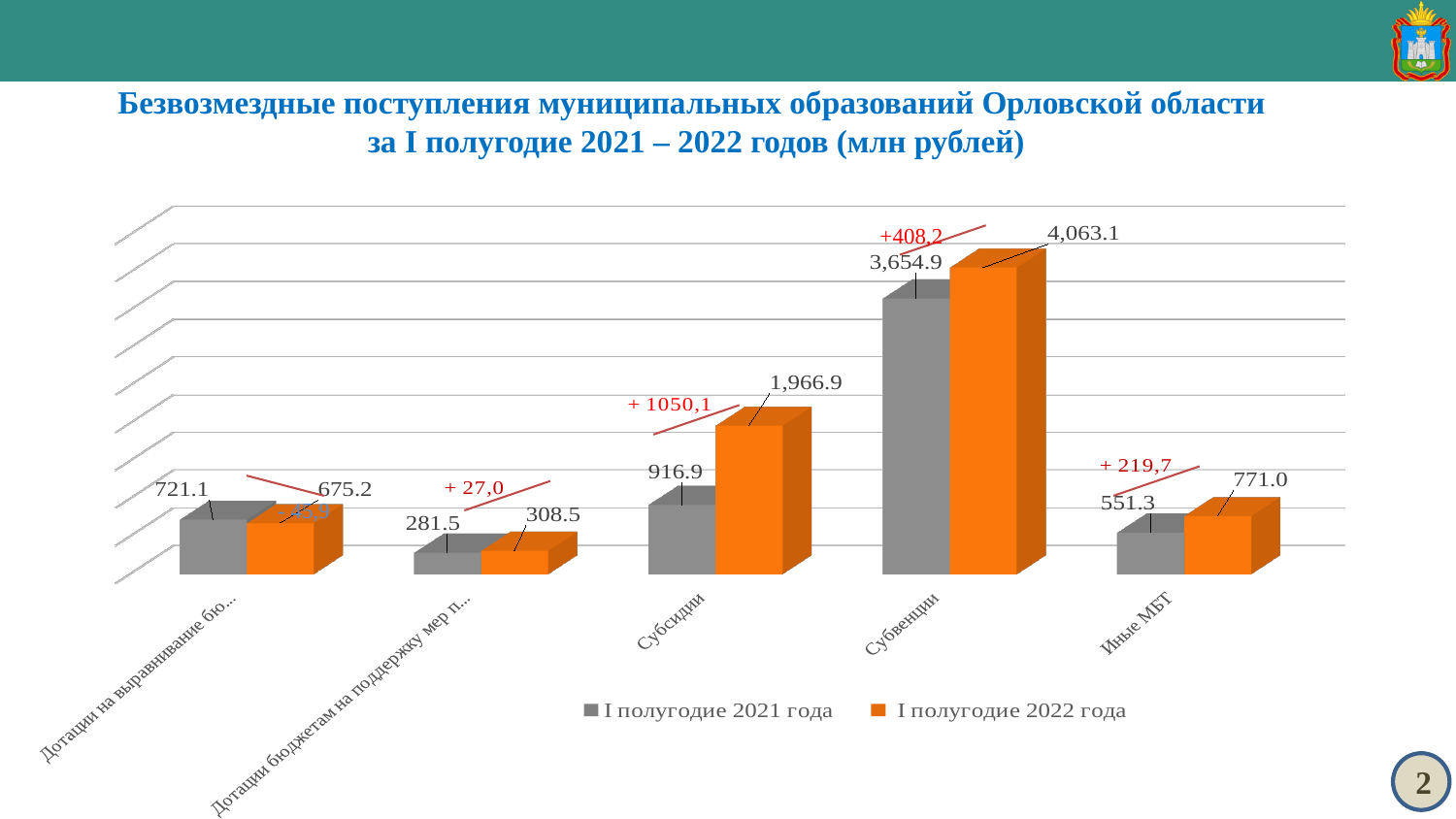
What is the value for Субвенции in I полугодие 2021 года? 3,654.9 What kind of chart is shown on the slide? bar chart What is the value for Иные МБТ in I полугодие 2021 года? 551.3 How many series does the legend list? 2 What is the value for Иные МБТ in I полугодие 2022 года? 771.0 How many categories are shown on the x axis of the chart? 5 Which is larger in I полугодие 2022 года: Субсидии or Иные МБТ? Субсидии What colour are the bars for I полугодие 2022 года? orange Which category has the highest value in I полугодие 2022 года? Субвенции What is the value for Субсидии in I полугодие 2021 года? 916.9 What is the value for Субсидии in I полугодие 2022 года? 1,966.9 What is the difference between the I полугодие 2022 года and I полугодие 2021 года values for Субвенции? 408.2